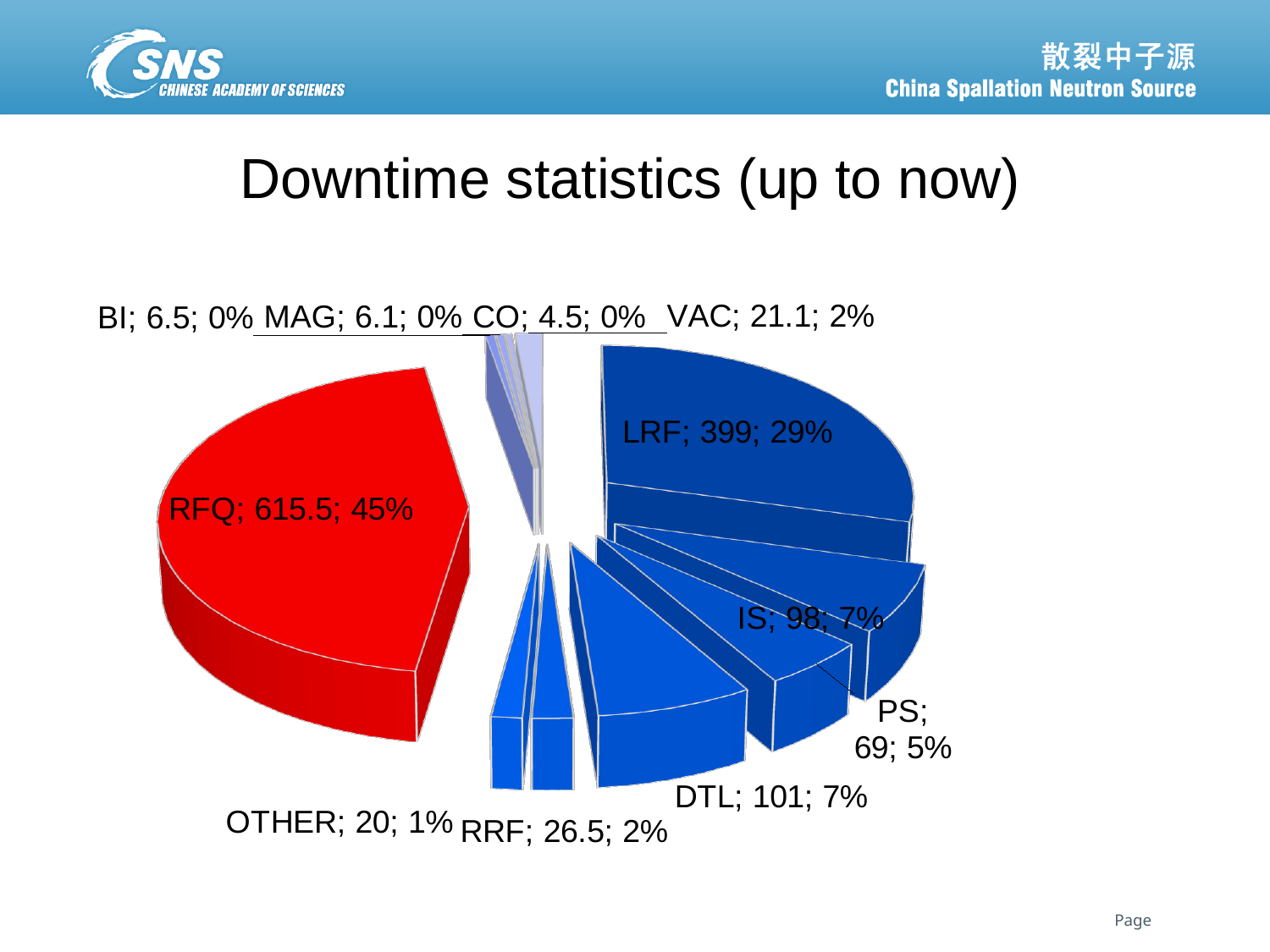
Which has a larger value, DTL or IS? DTL What is the downtime value for LRF? 399 What share of the pie does RFQ account for? 45% What is the downtime value for VAC? 21.1 Which category has the smallest value in the pie? CO What kind of chart is shown on the slide? pie chart What is the title of the chart? Downtime statistics (up to now) What is the downtime value for RFQ? 615.5 Which category has the largest slice of the pie? RFQ How many categories are shown in the pie chart? 11 What share of the pie does DTL account for? 7% What is the difference between the values for RFQ and LRF? 216.5